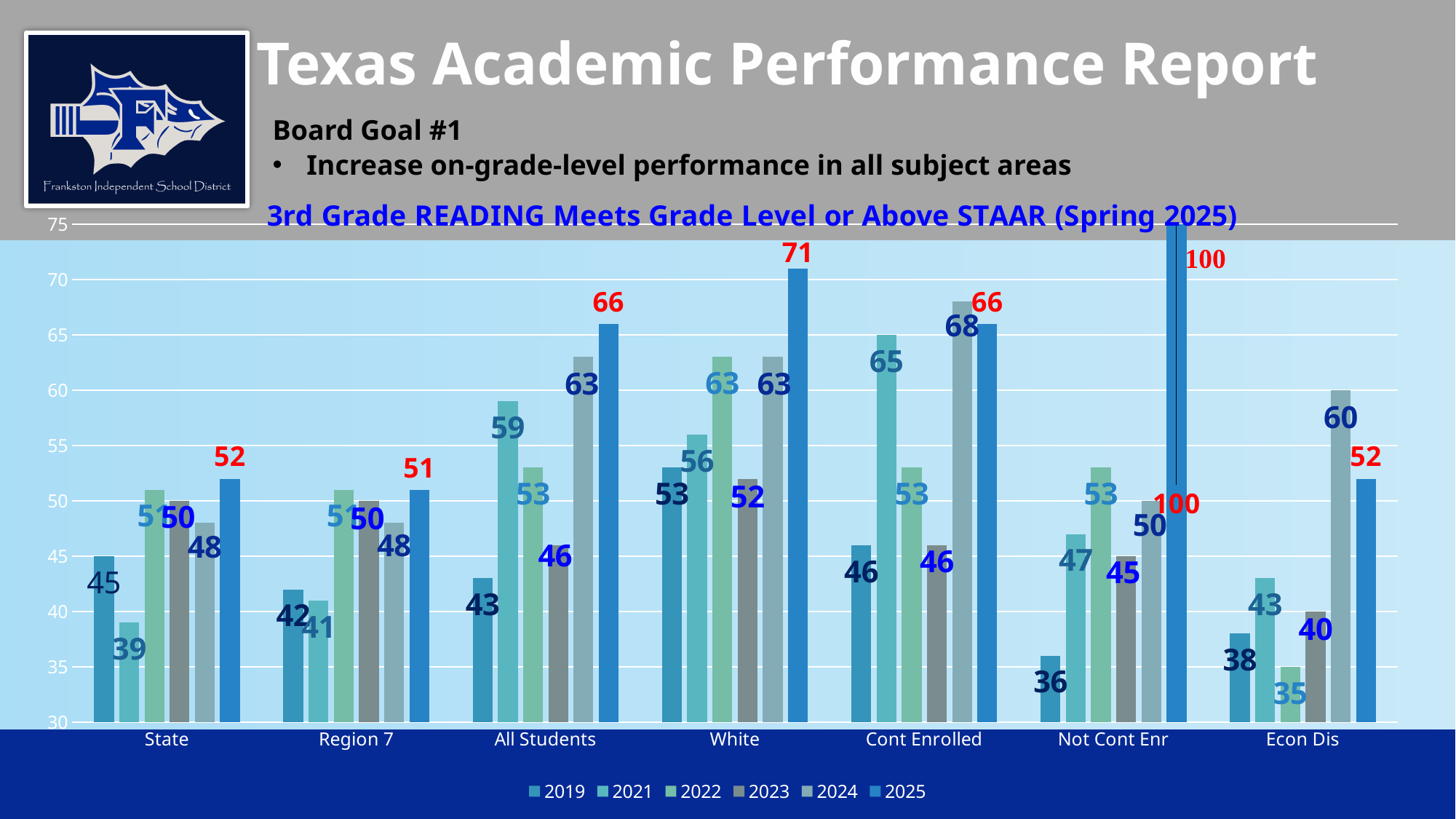
Which category has the highest 2025 value? Not Cont Enr Is the 2021 value for Econ Dis greater or less than 40? greater What kind of chart is shown on the slide? bar chart What is the difference between the 2025 and 2019 values for All Students? 23 Which is larger, the 2025 value for White or the 2025 value for Cont Enrolled? White How many categories are shown on the x axis? 7 Which category has the lowest 2019 value? Not Cont Enr Do the State values rise or fall from 2022 to 2024? fall How many series does the legend list? 6 What is the 2024 value for Cont Enrolled? 68 What is the 2019 value for State? 45 What is the 2025 value for White? 71